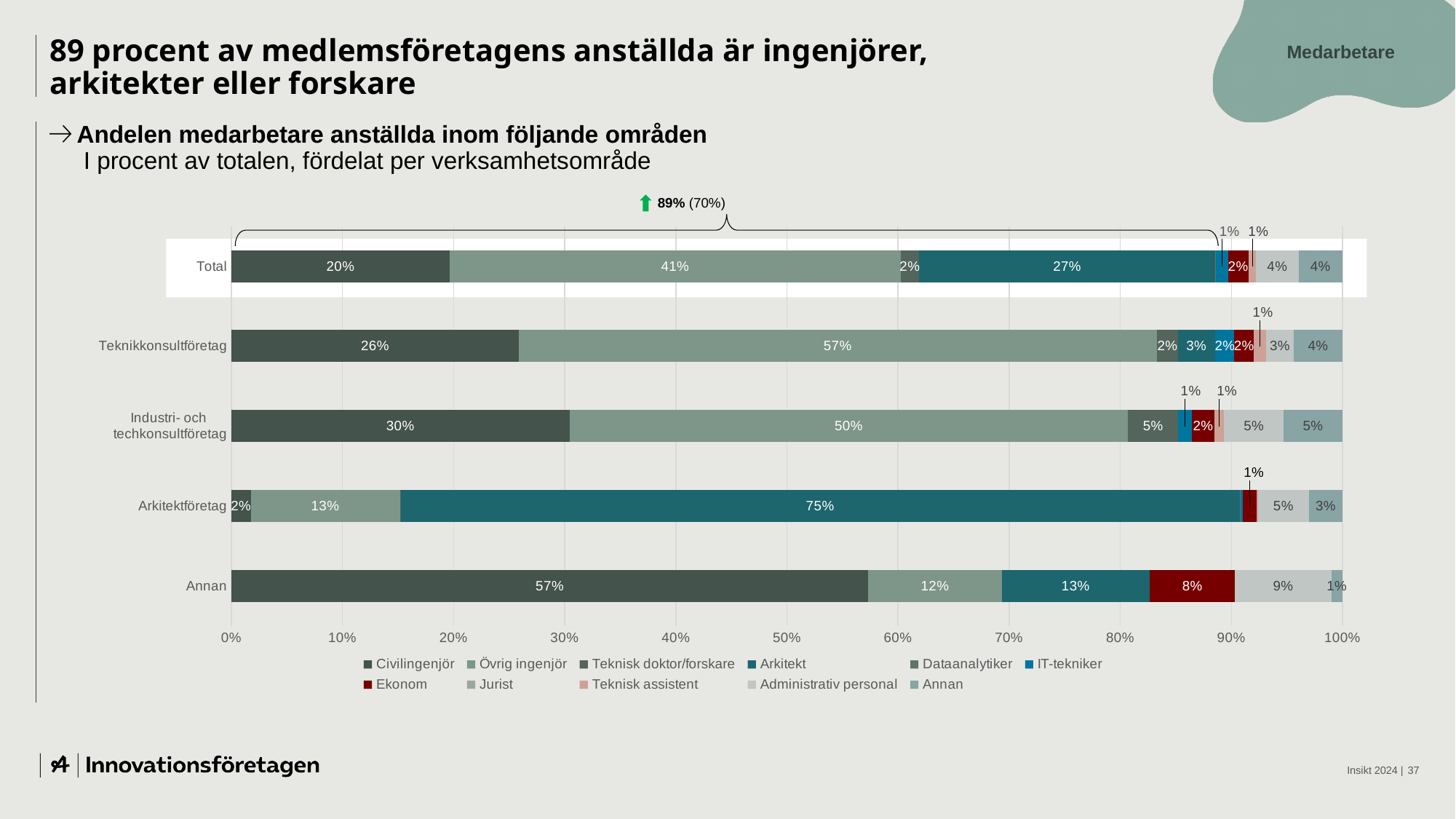
What is the share of Ekonom for Annan? 8% How many categories (rows) are plotted in the chart? 5 What is the share of Civilingenjör for Total? 20% What kind of chart is shown on the slide? Stacked bar chart What is the share of Arkitekt for Arkitektföretag? 75% What is the difference in the Civilingenjör share between Industri- och techkonsultföretag and Teknikkonsultföretag? 4 percentage points What percentage is shown in the annotation above the bracket over the Total bar? 89% (70%) What is the share of Övrig ingenjör for Teknikkonsultföretag? 57% Which category has the highest share of Arkitekt? Arkitektföretag Which has a larger share of Övrig ingenjör: Teknikkonsultföretag or Industri- och techkonsultföretag? Teknikkonsultföretag How many series does the legend list? 11 Which category has the highest share of Civilingenjör? Annan